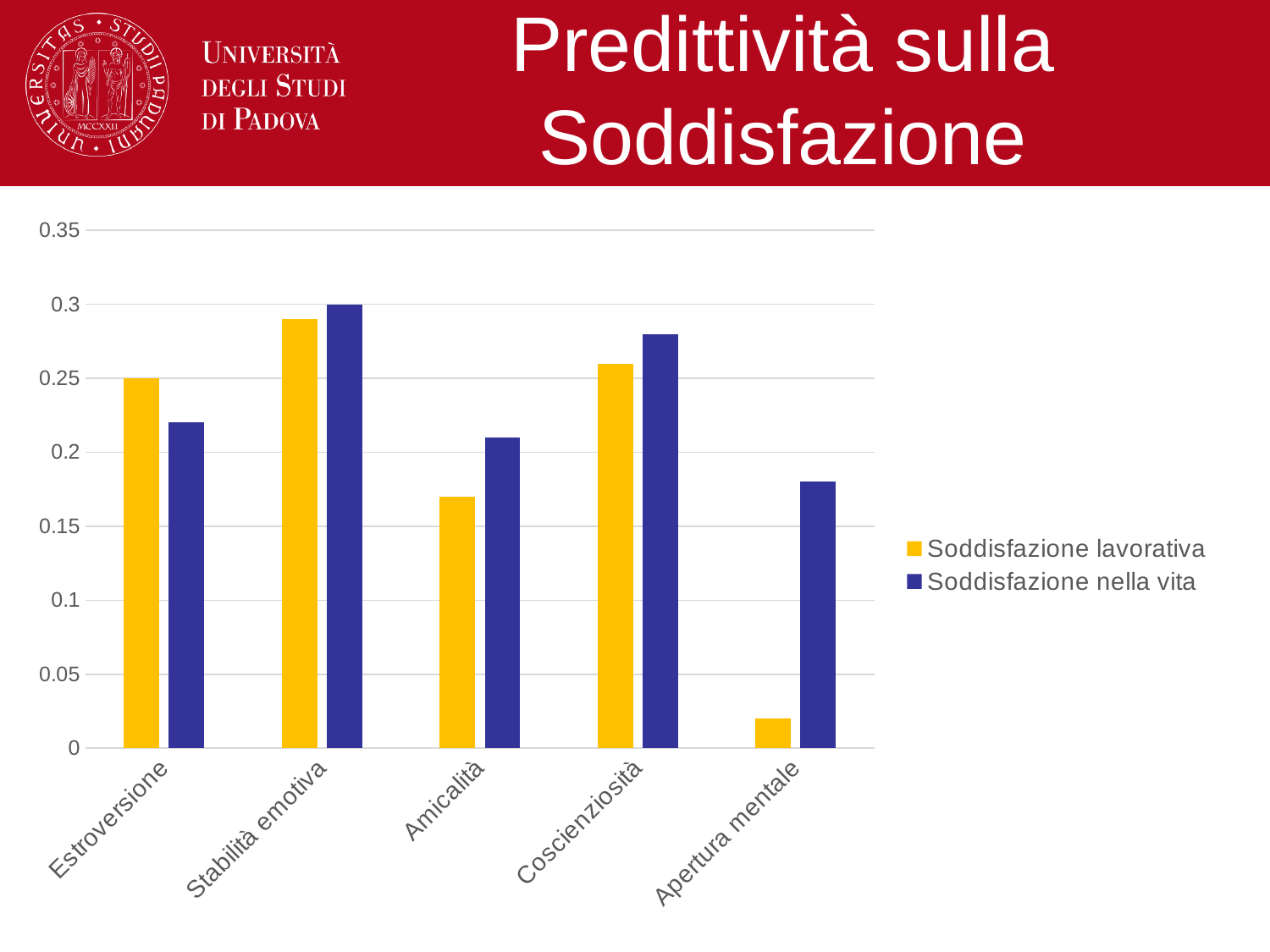
Is the value of Soddisfazione nella vita for Apertura mentale greater or less than 0.15? greater What is the value of Soddisfazione lavorativa for Estroversione? 0.25 Is the value of Soddisfazione lavorativa for Apertura mentale greater or less than 0.05? less What is the value of Soddisfazione nella vita for Stabilità emotiva? 0.3 How many series does the chart's legend list? 2 Which colour represents Soddisfazione lavorativa in the chart? yellow What kind of chart is shown on the slide? bar chart Is the value of Soddisfazione nella vita for Coscienziosità greater or less than 0.25? greater For Apertura mentale, which series has the larger value: Soddisfazione lavorativa or Soddisfazione nella vita? Soddisfazione nella vita Which category has the lowest value for Soddisfazione lavorativa? Apertura mentale How many categories are shown on the x axis of the chart? 5 Which category has the highest value for Soddisfazione lavorativa? Stabilità emotiva